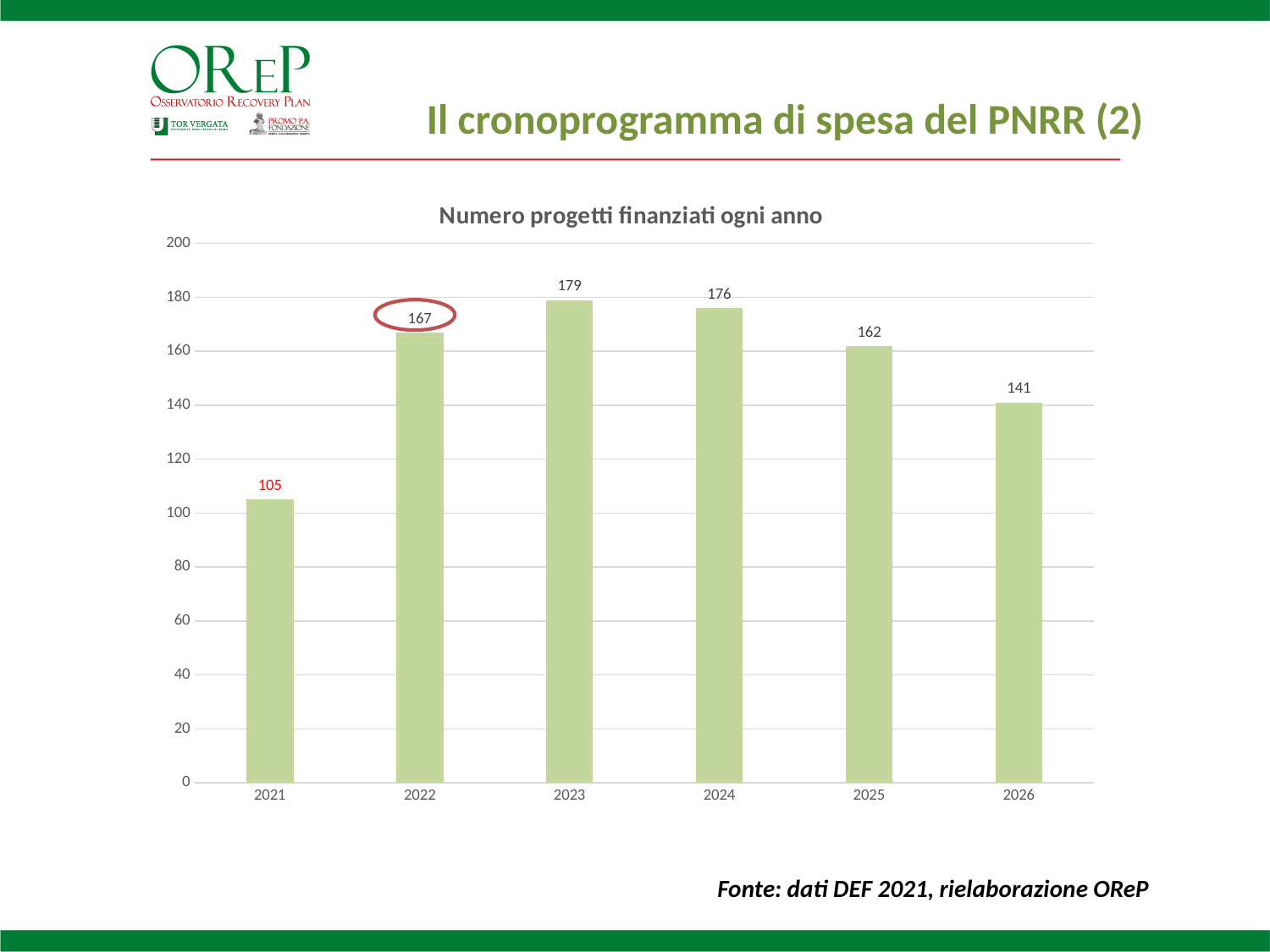
Which year has the lowest number of financed projects? 2021 What is the difference between the values for 2022 and 2025? 5 Is the value for 2025 greater or less than 140? greater What is the number of projects financed in 2021? 105 What is the value shown for 2026? 141 What is the difference between the values for 2023 and 2021? 74 What is the value shown for 2024? 176 Which is larger, the value for 2022 or the value for 2026? 2022 Which year has the highest number of financed projects? 2023 What is the title of the chart? Numero progetti finanziati ogni anno What kind of chart is shown on the slide? bar chart How many years are shown on the x axis? 6